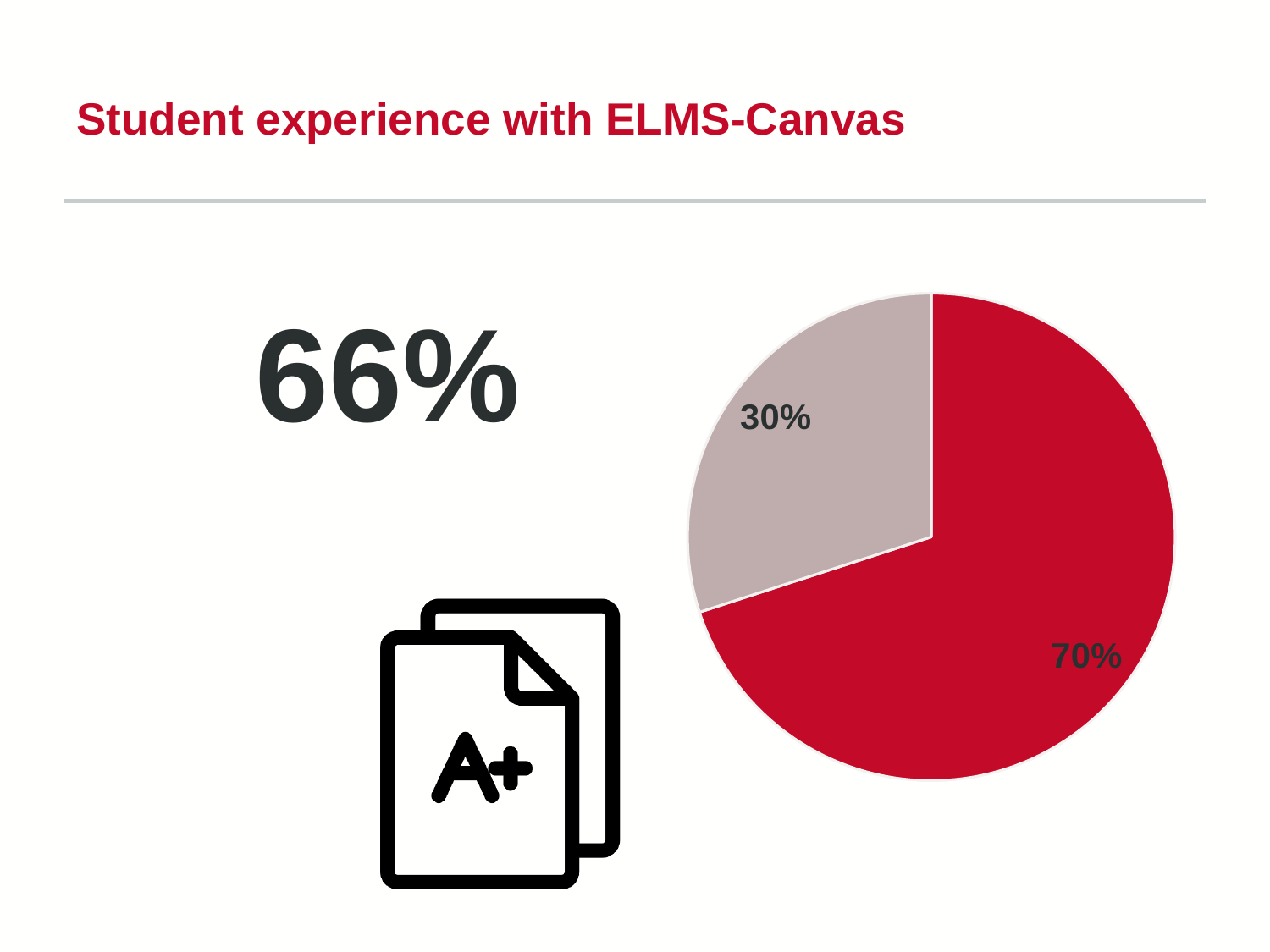
How many slices does the pie chart have? 2 What colour is the slice labelled 30%? Grey What is the difference in percentage points between the red slice and the grey slice? 40 percentage points What percentage is labelled on the grey slice of the pie chart? 30% Which slice of the pie chart is the smallest? The grey slice (30%) Is the red slice larger or smaller than the grey slice? Larger Is the red slice's share greater or less than half of the pie? Greater What do the two slice labels of the pie chart add up to? 100% What percentage is labelled on the red slice of the pie chart? 70% What kind of chart is shown on the slide? Pie chart What is the title of the slide containing the pie chart? Student experience with ELMS-Canvas Which slice of the pie chart is the largest? The red slice (70%)